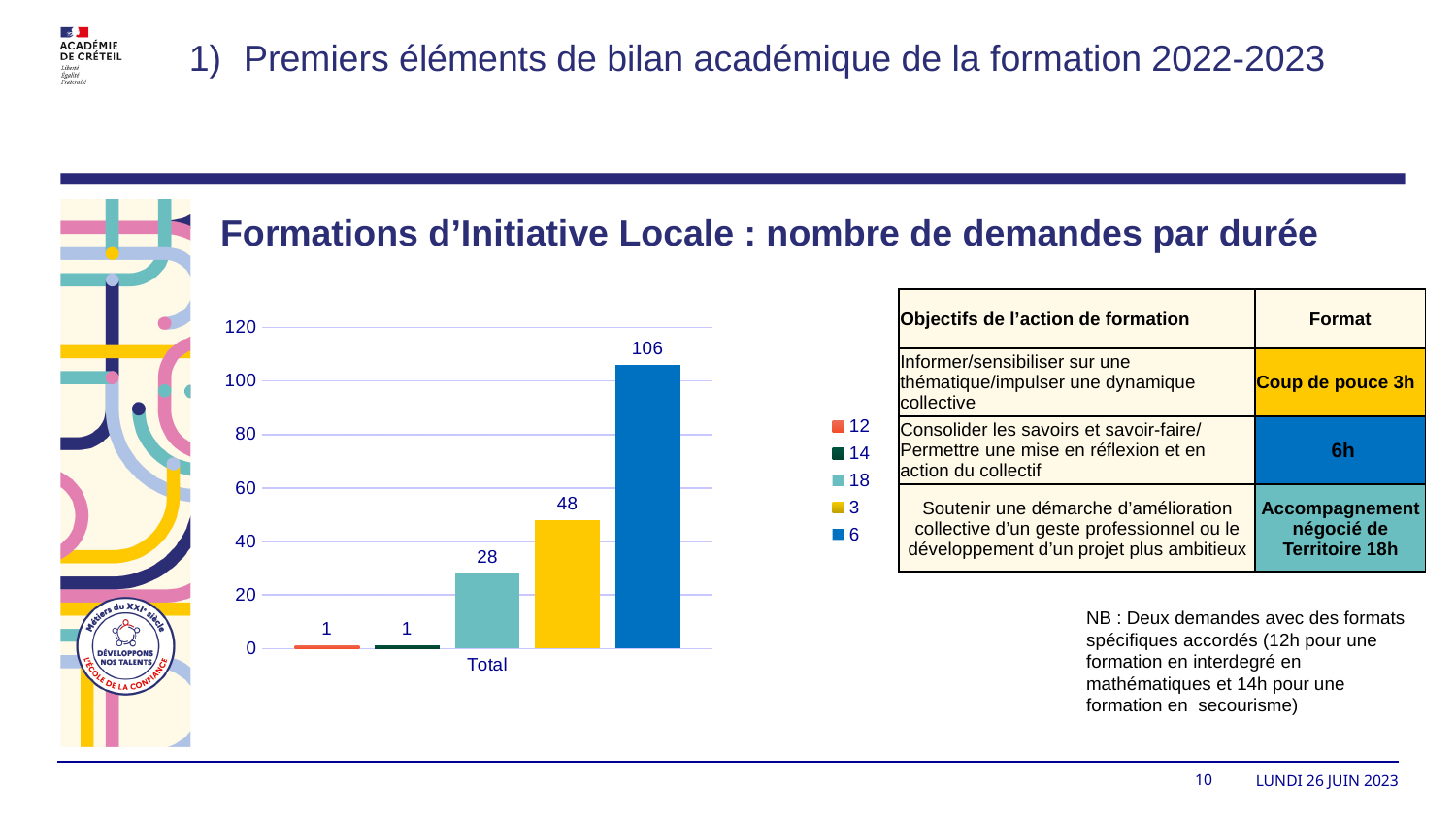
What is the title of the chart? Formations d’Initiative Locale : nombre de demandes par durée Is the value for series 6 greater or less than 100? greater What type of chart is shown on the slide? bar chart What is the value of the series labelled 18 in the chart? 28 What is the difference between the values of series 6 and series 3? 58 What is the category label shown on the x axis of the chart? Total What is the value of the series labelled 3 in the chart? 48 Which is larger, the value for series 18 or the value for series 3? 3 Which series has the highest value in the chart? 6 What is the value of the series labelled 12 in the chart? 1 What is the value of the series labelled 6 in the chart? 106 How many series does the chart legend list? 5